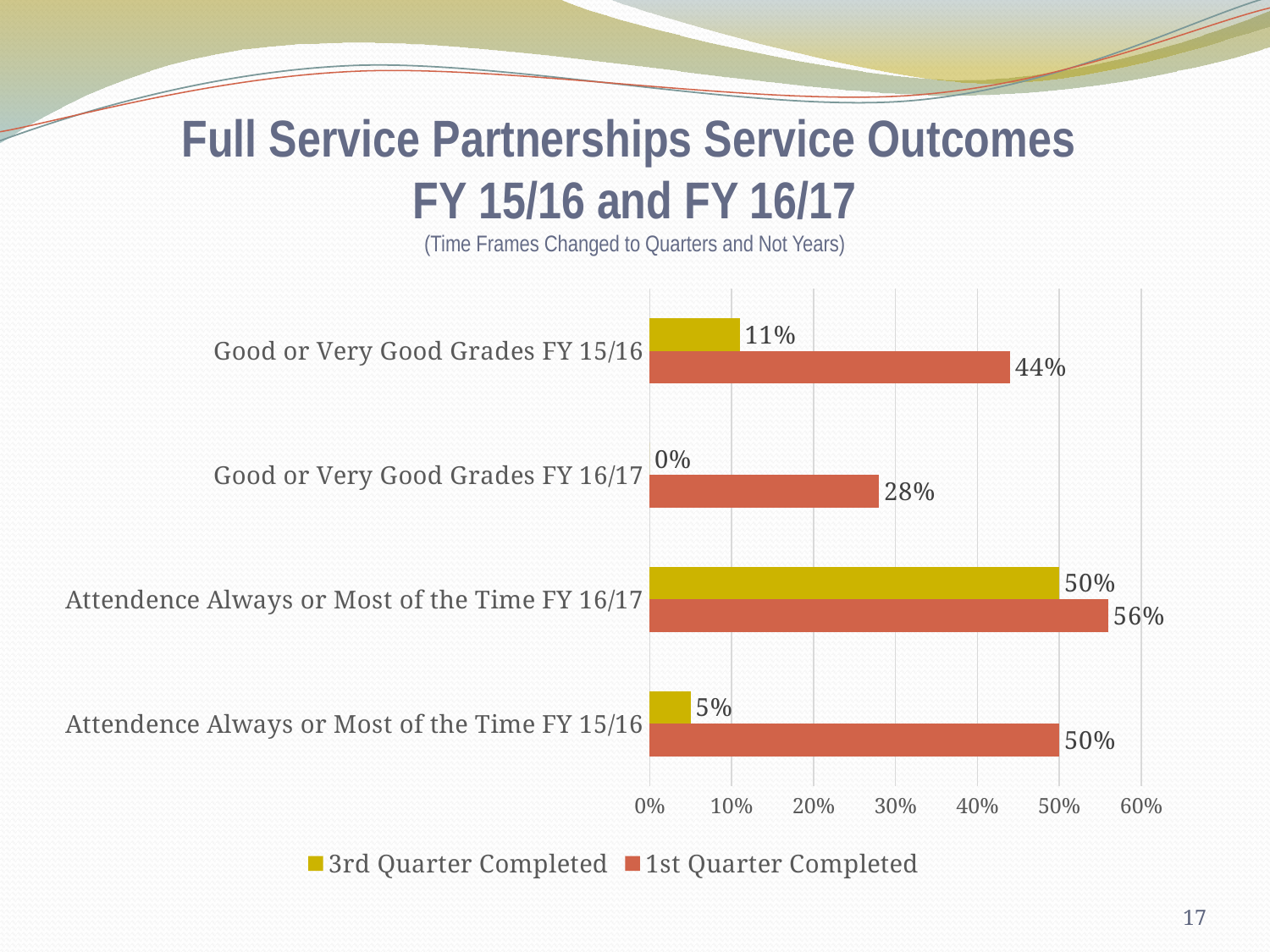
Which is larger for Attendence Always or Most of the Time FY 15/16: the 1st Quarter Completed value or the 3rd Quarter Completed value? 1st Quarter Completed How many categories are shown on the chart? 4 What kind of chart is shown on the slide? Bar chart Which category has the lowest 3rd Quarter Completed value? Good or Very Good Grades FY 16/17 What is the 3rd Quarter Completed value for Good or Very Good Grades FY 16/17? 0% What is the 1st Quarter Completed value for Good or Very Good Grades FY 15/16? 44% Which category has the highest 1st Quarter Completed value? Attendence Always or Most of the Time FY 16/17 What is the 1st Quarter Completed value for Attendence Always or Most of the Time FY 15/16? 50% How many series does the legend list? 2 What is the difference between the 1st Quarter Completed and 3rd Quarter Completed values for Good or Very Good Grades FY 15/16? 33% What is the 3rd Quarter Completed value for Attendence Always or Most of the Time FY 16/17? 50% Is the 1st Quarter Completed value for Good or Very Good Grades FY 16/17 greater or less than 30%? less